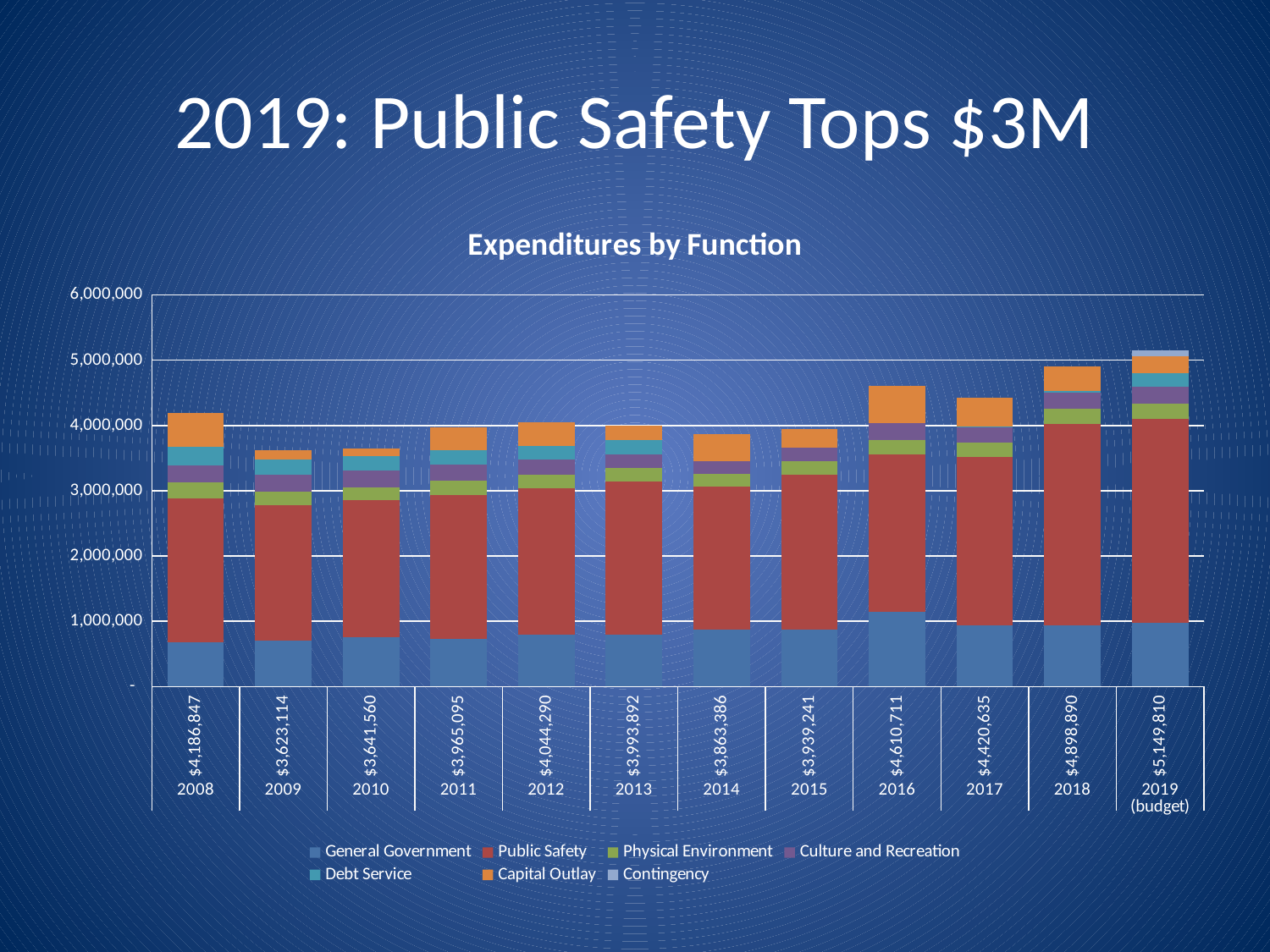
Is the total expenditure for 2019 (budget) greater or less than 5,000,000? greater Which year has the highest total expenditure? 2019 (budget) How many series does the legend list? 7 Which year has the lowest total expenditure? 2009 What is the difference between the total expenditures for 2019 (budget) and 2018? $250,920 Which year has the larger total expenditure, 2012 or 2013? 2012 What is the total expenditure shown for 2008? $4,186,847 What is the title of the chart? Expenditures by Function What kind of chart is shown on the slide? Stacked bar chart What is the total expenditure shown for 2016? $4,610,711 What is the total expenditure shown for 2019 (budget)? $5,149,810 How many years are shown on the x axis of the chart? 12